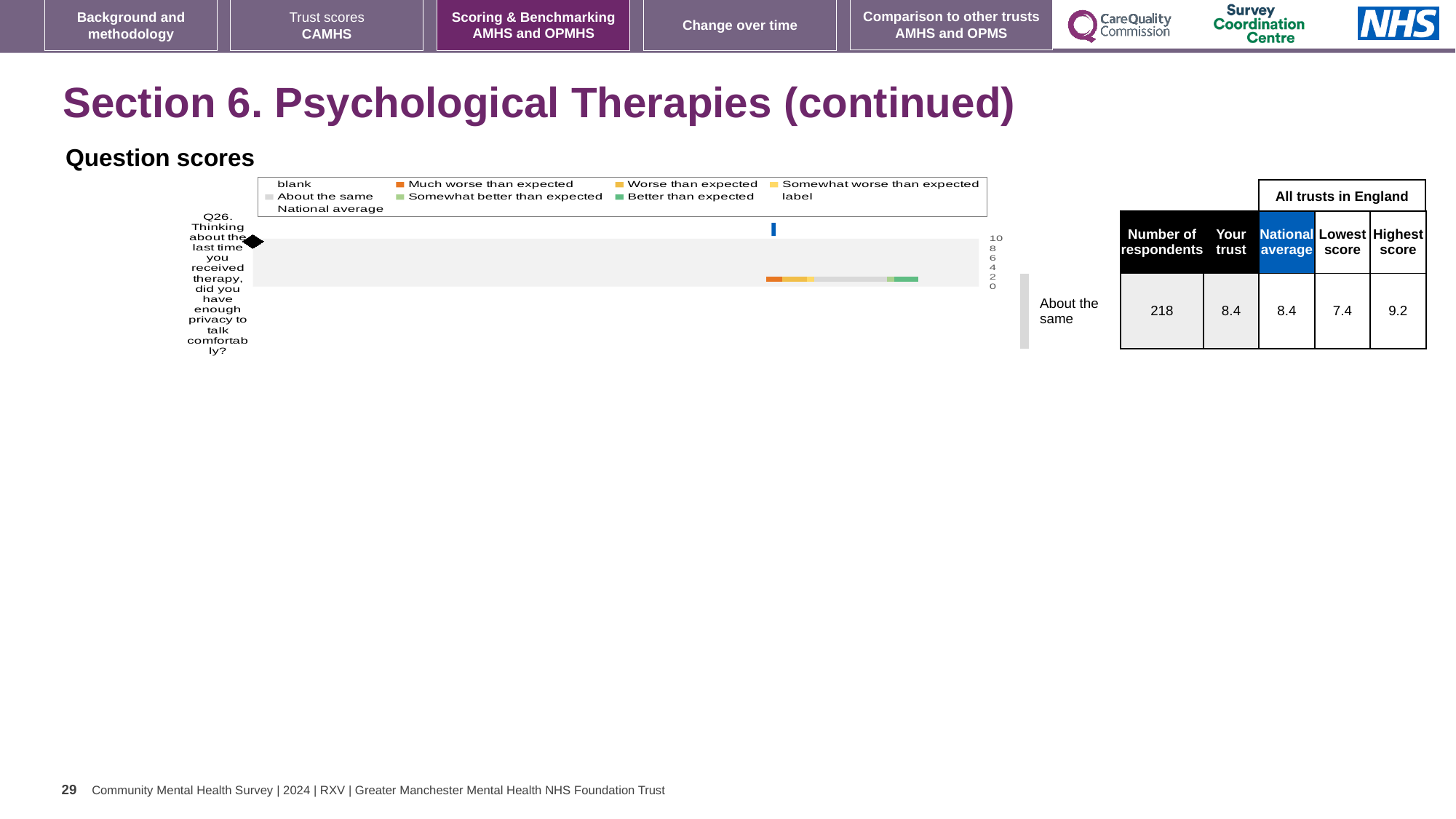
How many questions are plotted in the Question scores chart? 1 What is the national average score for Q26? 8.4 What is the lowest score among all trusts in England for Q26? 7.4 What kind of chart is shown under 'Question scores'? bar chart What is the highest score among all trusts in England for Q26? 9.2 Which legend entry is shown in orange in the Question scores chart? Much worse than expected What is the 'Your trust' score for Q26? 8.4 What is the number of respondents for Q26 in the table beside the chart? 218 What benchmark category is the trust's Q26 result labelled as next to the chart? About the same How much higher is the highest score in England than the trust's score for Q26? 0.8 What is the difference between the highest and lowest scores for Q26 across all trusts in England? 1.8 Is the trust's score for Q26 higher than, lower than, or the same as the national average? the same